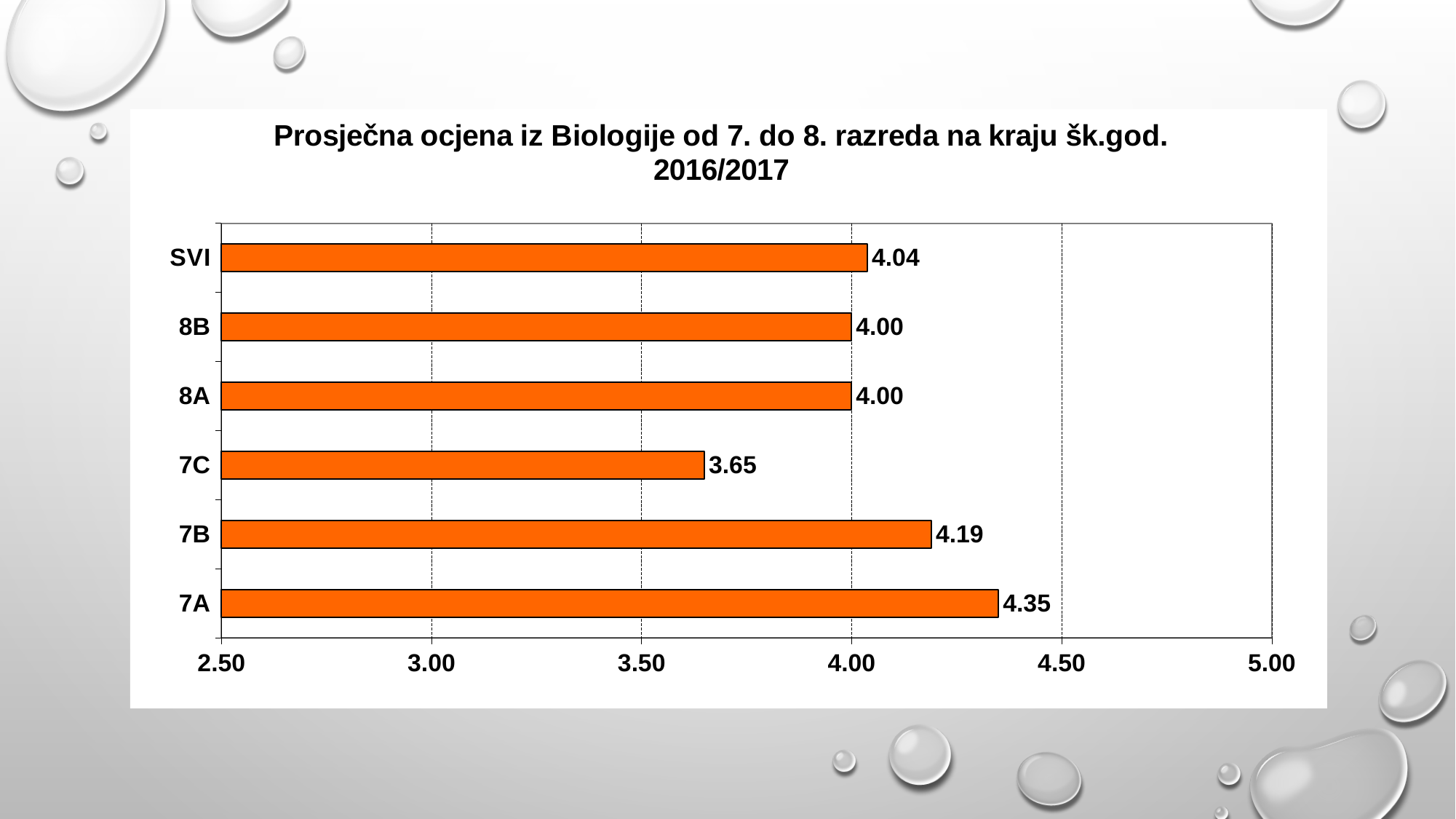
What colour are the bars in the chart? orange How many categories are shown on the chart? 6 Which class has the lowest average grade? 7C Which class has the highest average grade? 7A What kind of chart is shown on the slide? bar chart What is the value shown for SVI? 4.04 What is the average Biology grade for class 7A? 4.35 Is the value for 7C greater or less than 4.00? less What is the difference between the values for 7A and 7C? 0.70 What is the value shown for 7C? 3.65 What is the difference between the values for 7B and 8A? 0.19 Which is larger, the value for 7B or the value for 8B? 7B